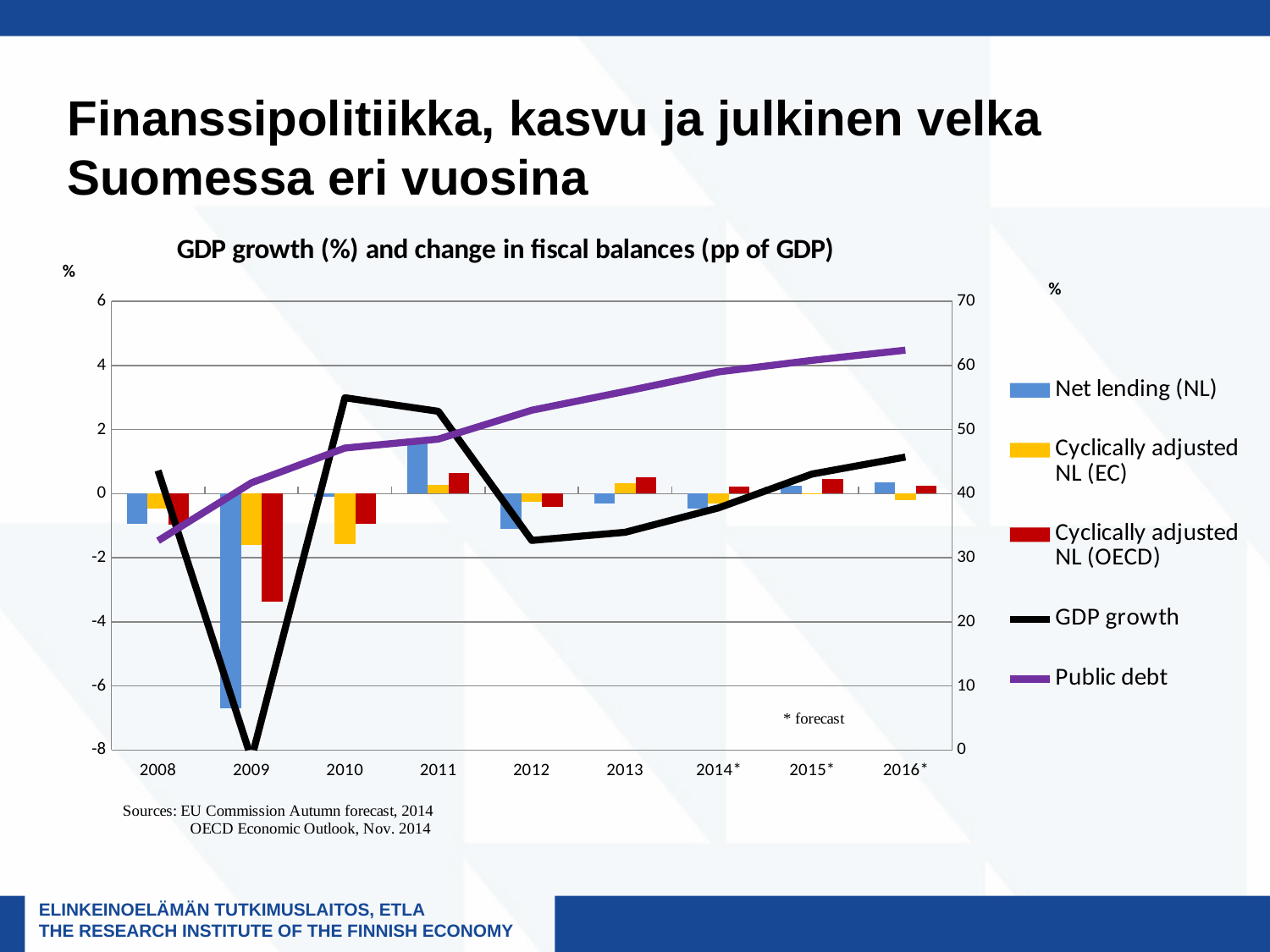
Is the Cyclically adjusted NL (OECD) value for 2009 greater or less than -2? less Does Public debt rise or fall from 2008 to 2016*? rise In which year is GDP growth highest? 2010 How many series does the legend list? 5 In which year is Net lending (NL) lowest? 2009 Is the Public debt value for 2008 greater or less than 40 on the right axis? less Is the GDP growth value for 2009 greater or less than -6? less How many years are shown on the x axis? 9 Which is larger, Net lending (NL) in 2009 or in 2012? 2012 What kind of chart is this? A combined bar and line chart What is the title of the chart? GDP growth (%) and change in fiscal balances (pp of GDP)